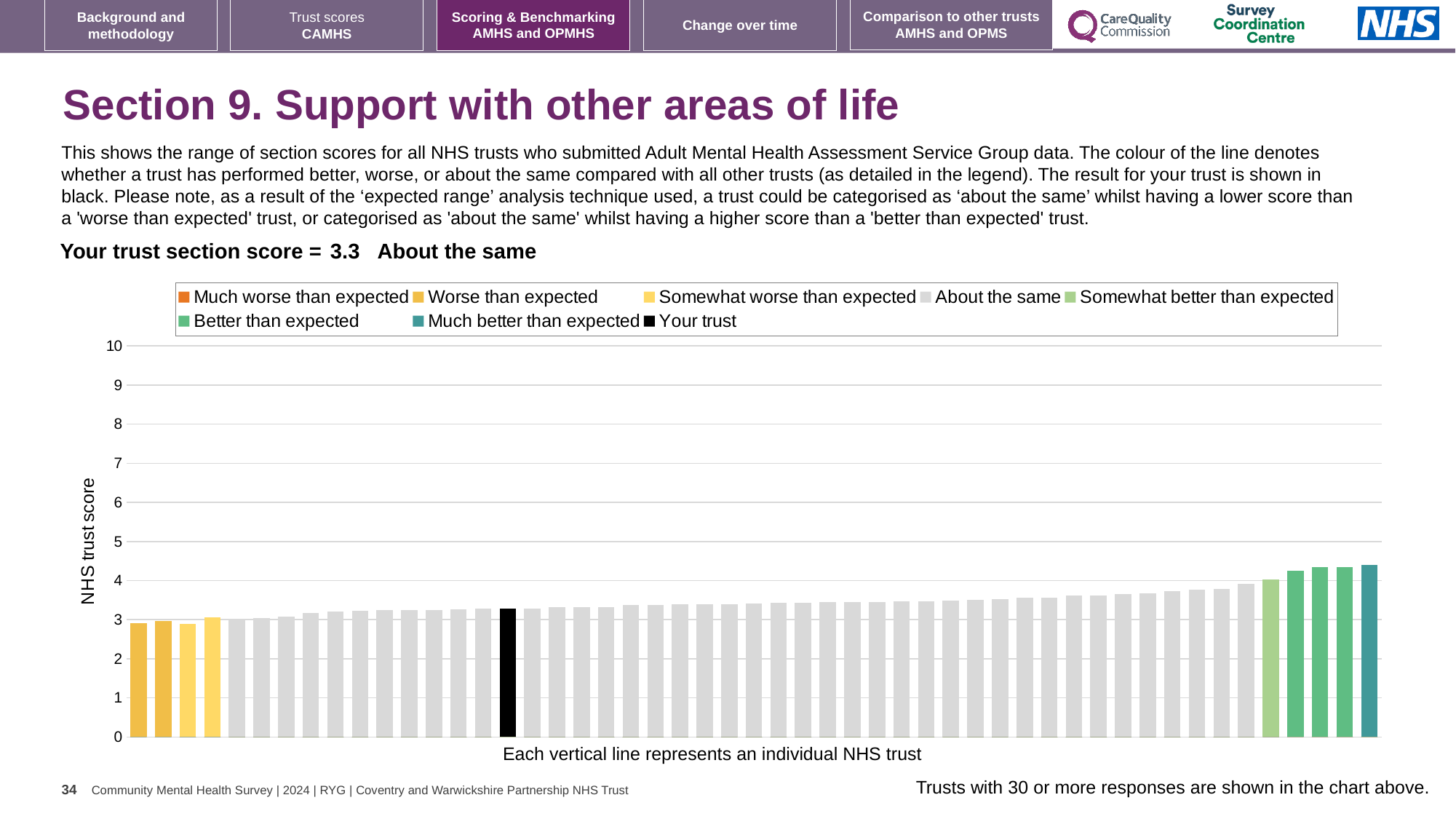
What is the label on the vertical axis of the chart? NHS trust score Do the bar values rise or fall from left to right along the x axis? rise What kind of chart is shown on the slide? bar chart Which legend category does the tallest bar in the chart belong to? Much better than expected Is the value of the shortest bar in the chart greater or less than 3? less Is the value of the black 'Your trust' bar greater or less than 4? less Is the value of the black 'Your trust' bar greater or less than 3? greater What colour is used for the 'Your trust' bar in the chart? black How many entries does the chart legend list? 8 What is the section score for your trust shown on the slide? 3.3